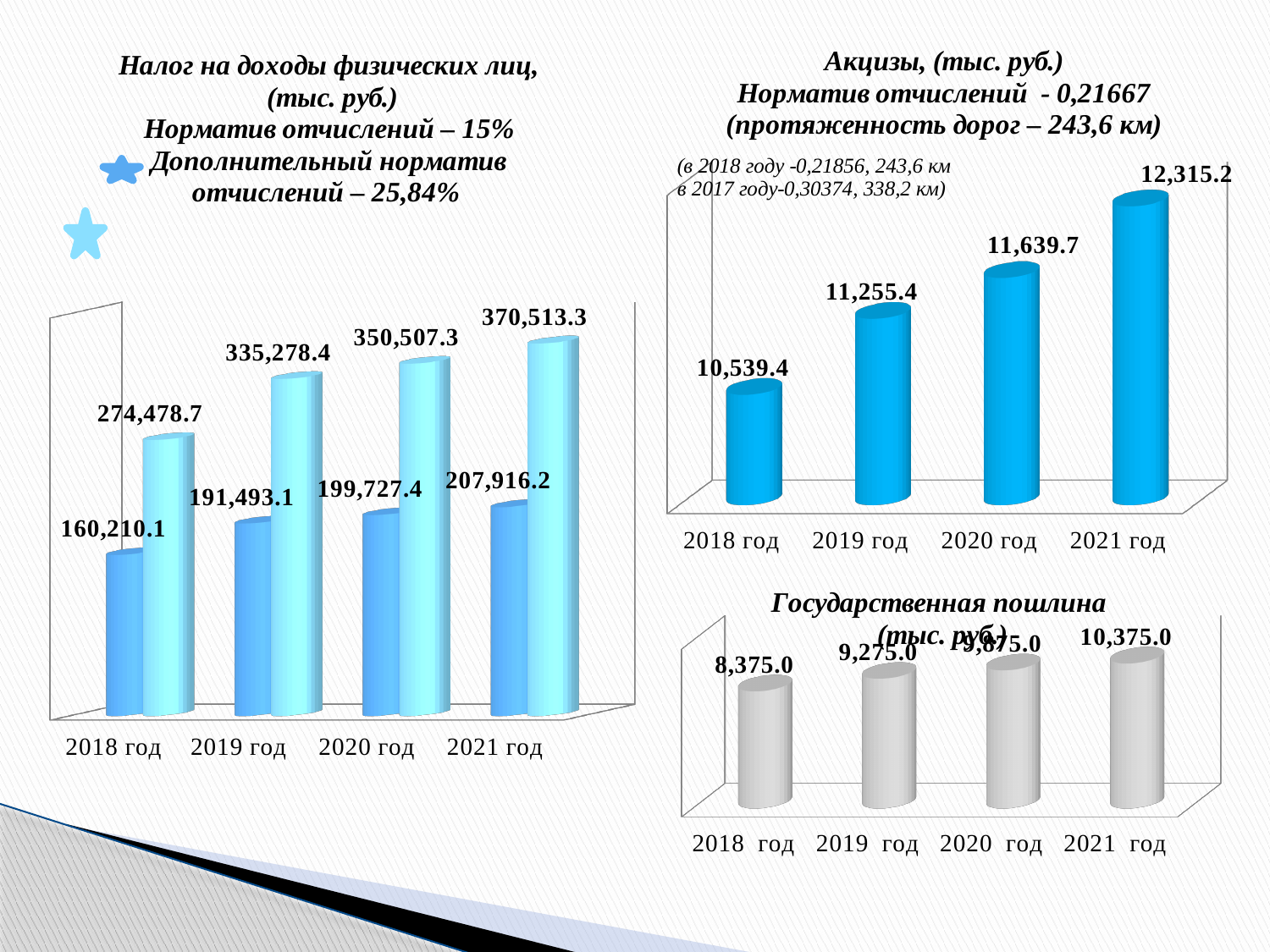
In the 'Налог на доходы физических лиц' chart, what is the value of the dark blue bar for 2018 год? 160,210.1 In the 'Государственная пошлина' chart, which year has the lowest value? 2018 год In the 'Государственная пошлина' chart, what is the value for 2021 год? 10,375.0 What kind of chart is the 'Государственная пошлина' chart? bar chart In the 'Акцизы' chart, what is the difference between the 2021 год and 2018 год values? 1,775.8 In the 'Государственная пошлина' chart, what is the value for 2018 год? 8,375.0 In the 'Акцизы' chart, which year has the highest value? 2021 год In the 'Акцизы' chart, do the values rise or fall from 2018 год to 2021 год? rise In the 'Акцизы' chart, what is the value for 2018 год? 10,539.4 In the 'Налог на доходы физических лиц' chart, how many years are shown on the x axis? 4 In the 'Налог на доходы физических лиц' chart, what is the value of the light blue bar for 2021 год? 370,513.3 In the 'Акцизы' chart, what is the value for 2021 год? 12,315.2